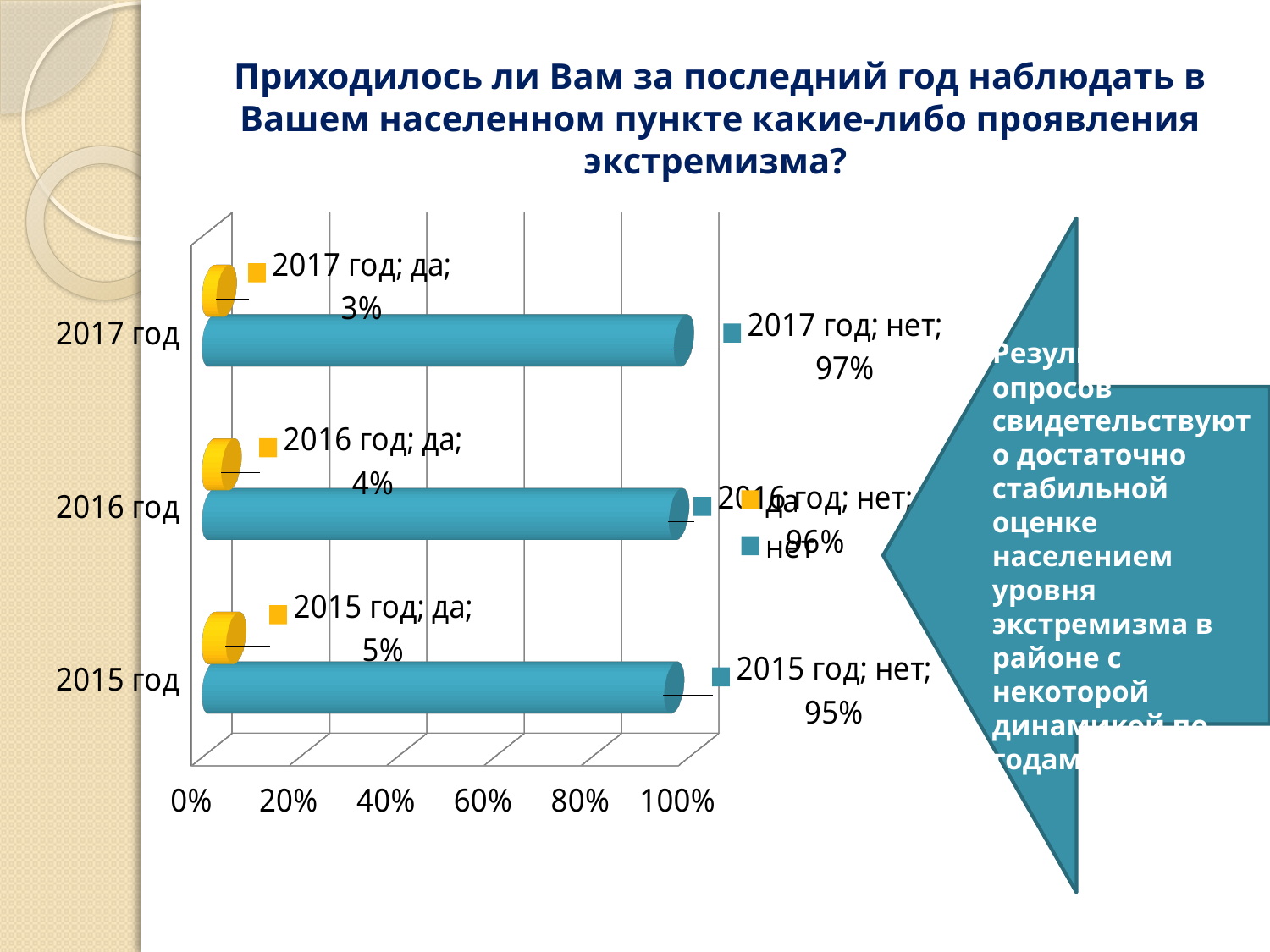
In which year was the share of "да" answers highest? 2015 год In which year was the share of "нет" answers lowest? 2015 год What is the difference between the "нет" values for 2017 and 2015? 2% What is the value for "нет" in 2016? 96% How many years are shown on the chart? 3 What is the value for "да" in 2015? 5% How many series does the legend list? 2 Which is larger: the "да" value for 2016 or for 2017? 2016 год What percentage answered "нет" in 2015? 95% What percentage answered "да" in 2017? 3% Is the value for "нет" in 2016 greater or less than 80%? greater What kind of chart is shown on the slide? bar chart